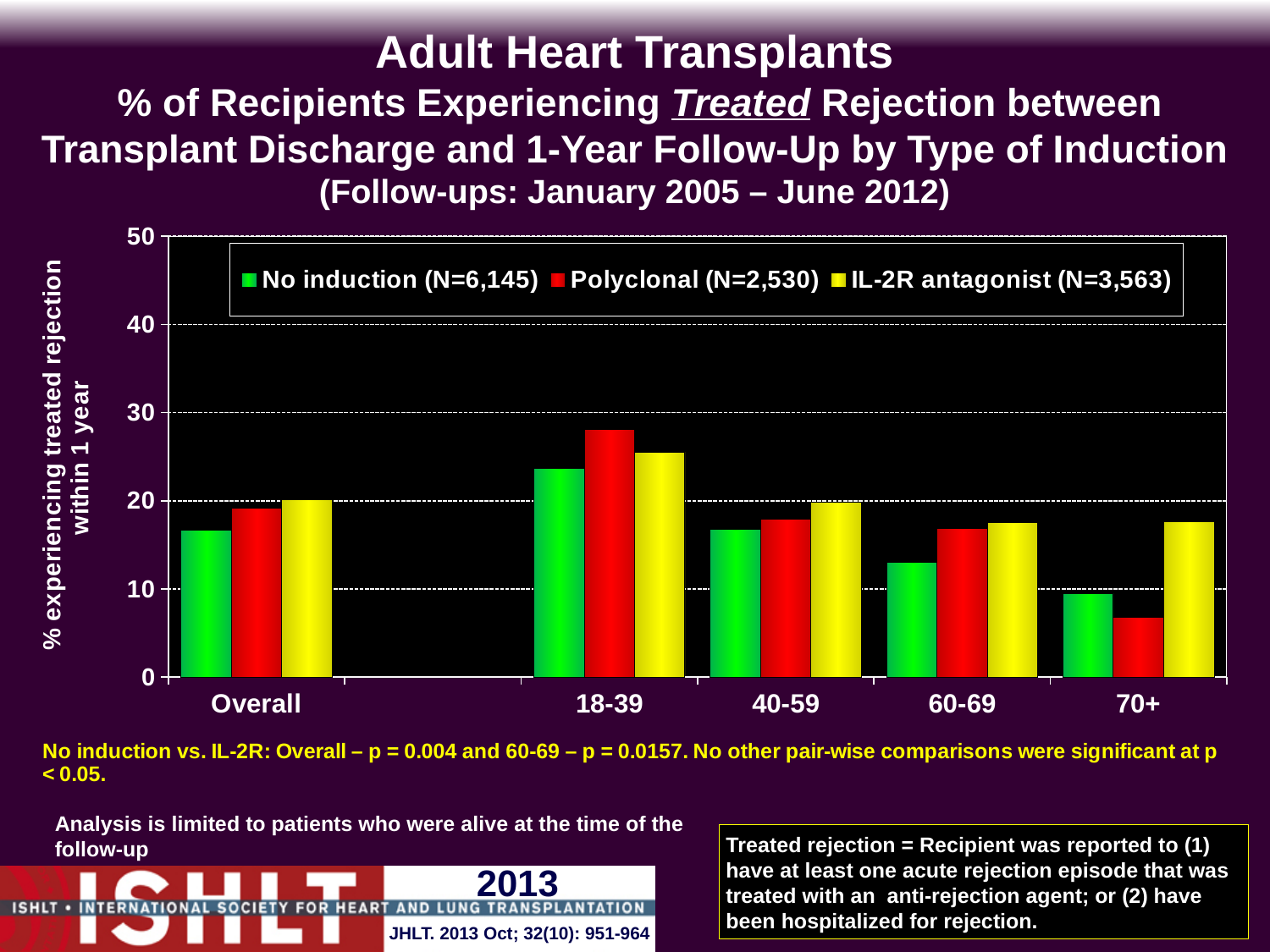
Is the value for No induction in the 60-69 group greater or less than 10? greater In the 70+ group, which is larger: Polyclonal or IL-2R antagonist? IL-2R antagonist Is the value for Polyclonal in the 70+ group greater or less than 10? less What is the N given in the legend for the Polyclonal series? N=2,530 How many categories are shown along the x axis? 5 How many series does the legend list? 3 Which category has the highest value for the No induction series? 18-39 Do the No induction values rise or fall across the age groups from 18-39 to 70+? fall Is the value for Polyclonal in the 18-39 group greater or less than 20? greater What kind of chart is shown on the slide? bar chart Which category has the lowest value for the Polyclonal series? 70+ Which category has the highest value for the Polyclonal series? 18-39